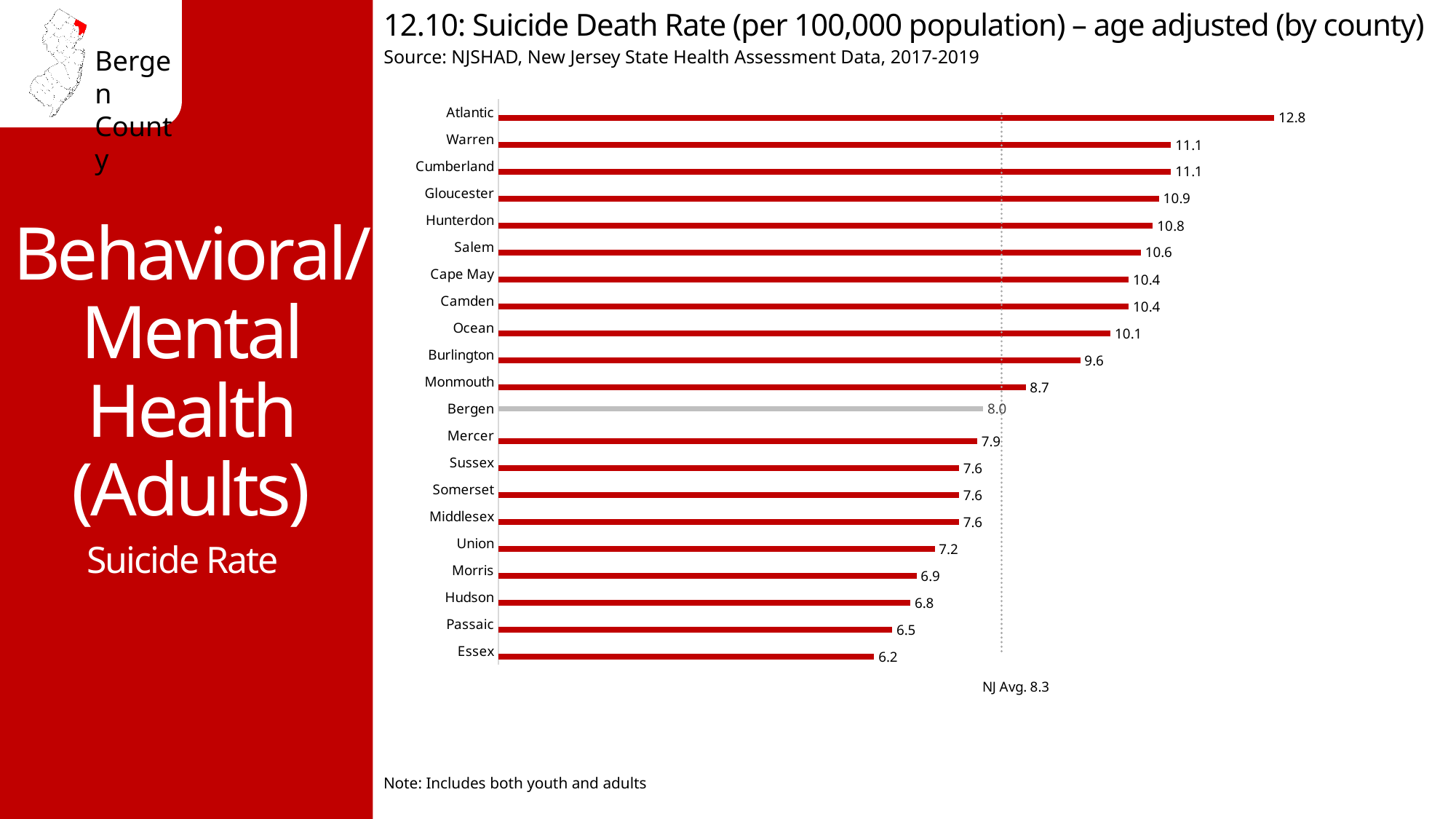
What is the difference between the suicide death rates of Atlantic and Bergen? 4.8 What is the suicide death rate for Bergen County? 8.0 Which has a higher suicide death rate, Hudson or Union? Union What is the NJ average suicide death rate marked on the chart? 8.3 What is the difference between the suicide death rates of Monmouth and Mercer? 0.8 How many counties are shown in the chart? 21 What is the suicide death rate for Essex County? 6.2 Which has a higher suicide death rate, Ocean or Burlington? Ocean What kind of chart is shown on the slide? Bar chart What is the suicide death rate for Atlantic County? 12.8 Which county has the highest suicide death rate? Atlantic Which county has the lowest suicide death rate? Essex